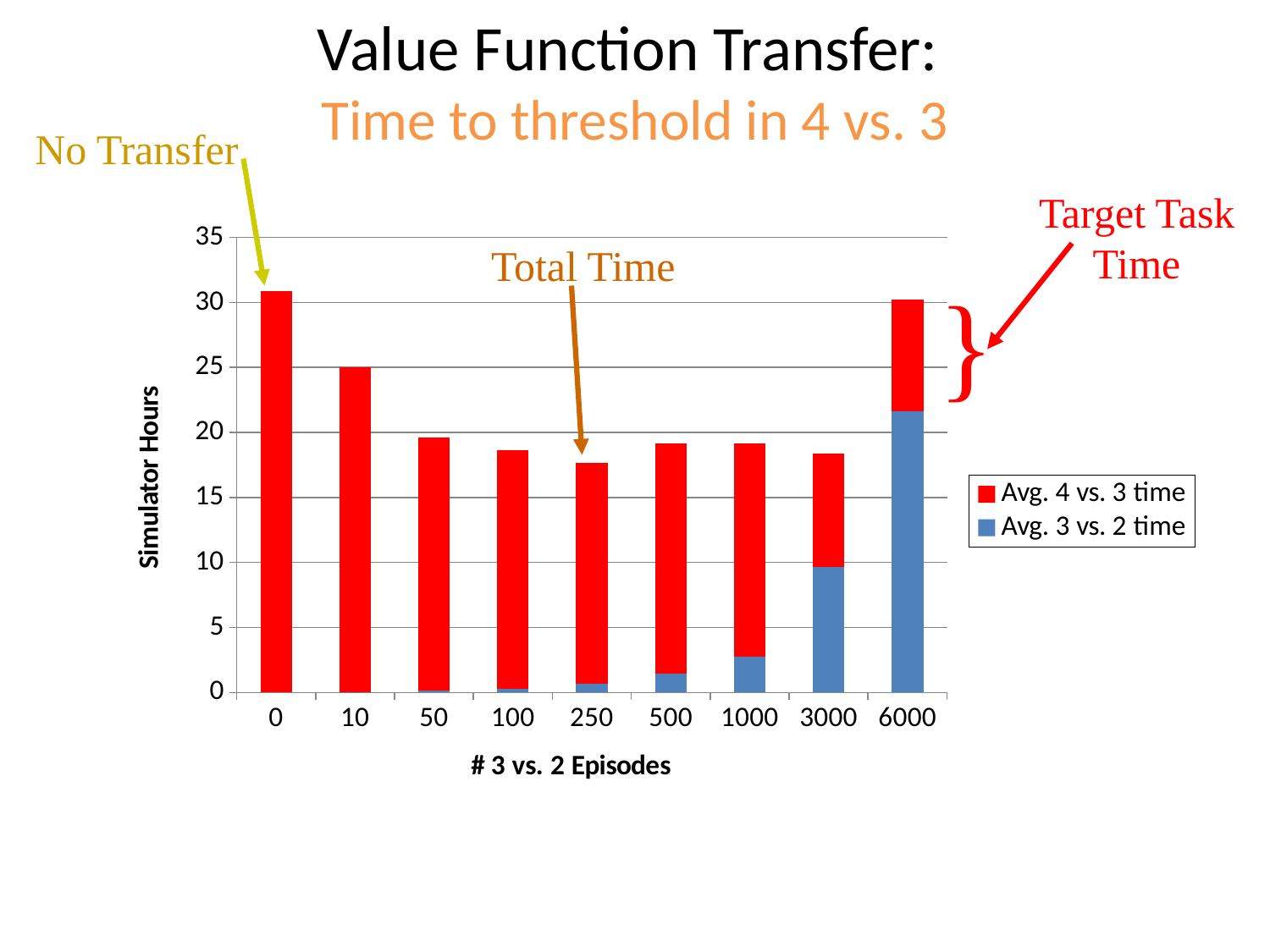
Which category has the largest Avg. 3 vs. 2 time? 6000 Which has a taller total bar, 10 episodes or 50 episodes? 10 Is the Avg. 3 vs. 2 time for 6000 episodes greater or less than 20 simulator hours? greater Is the total bar height for 250 episodes greater or less than 20 simulator hours? less What kind of chart is shown on the slide? stacked bar chart Does the total bar height rise or fall from 0 episodes to 250 episodes? fall Is the total bar height for 0 episodes greater or less than 30 simulator hours? greater How many series does the legend list? 2 What is the label of the y axis? Simulator Hours What is the label of the x axis? # 3 vs. 2 Episodes How many categories are shown on the x axis? 9